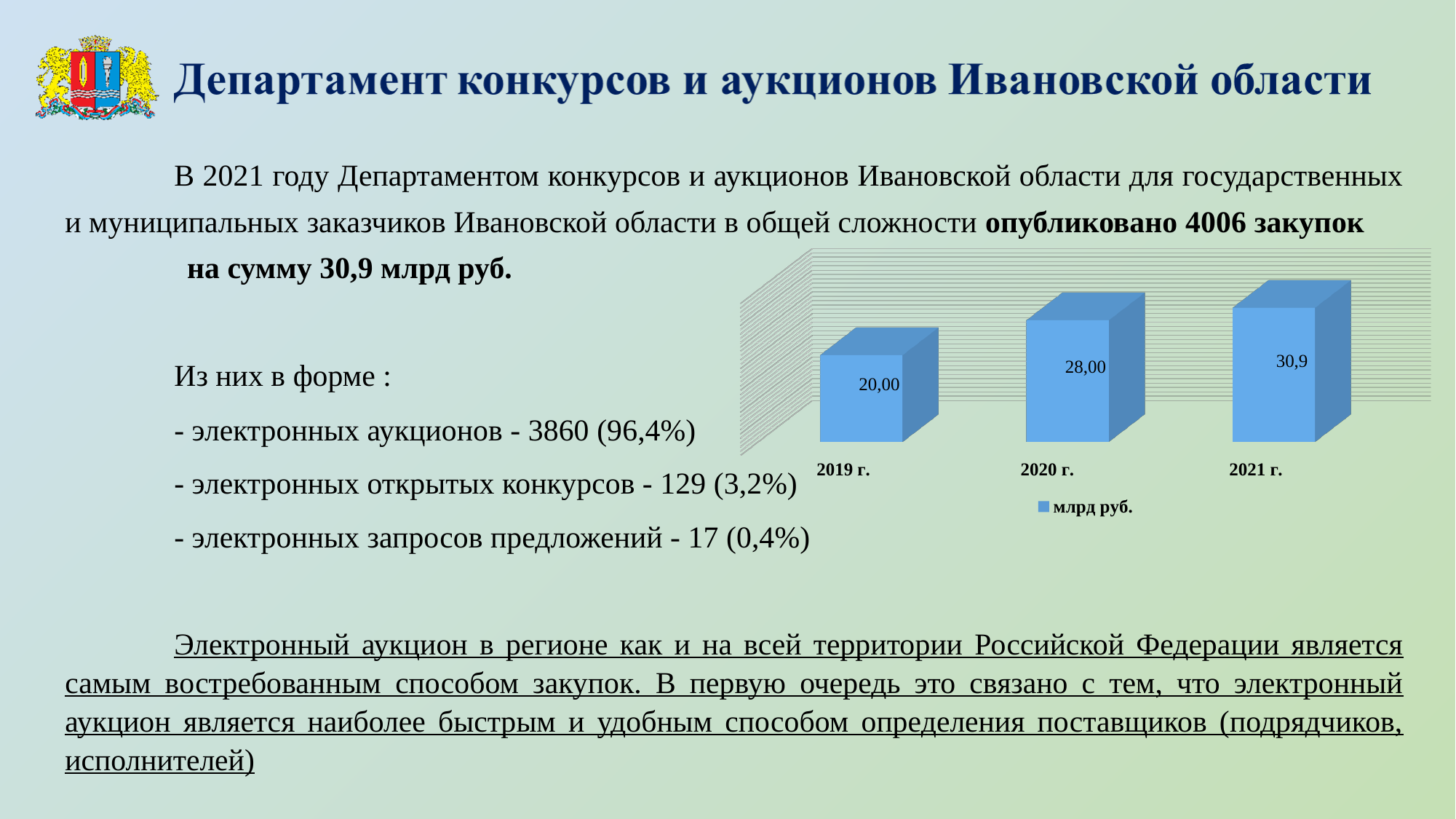
How many series does the chart legend list? 1 What kind of chart is shown on the slide? Bar chart What is the value shown for 2019 г. in the chart? 20,00 What is the value shown for 2020 г. in the chart? 28,00 Do the values rise or fall from 2019 г. to 2021 г.? Rise How many bars are shown in the chart? 3 Which year has the highest value in the chart? 2021 г. Which is larger, the value for 2020 г. or the value for 2019 г.? 2020 г. What is the value shown for 2021 г. in the chart? 30,9 Which year has the lowest value in the chart? 2019 г. What is the difference between the values for 2021 г. and 2020 г.? 2,9 What is the difference between the values for 2020 г. and 2019 г.? 8,00